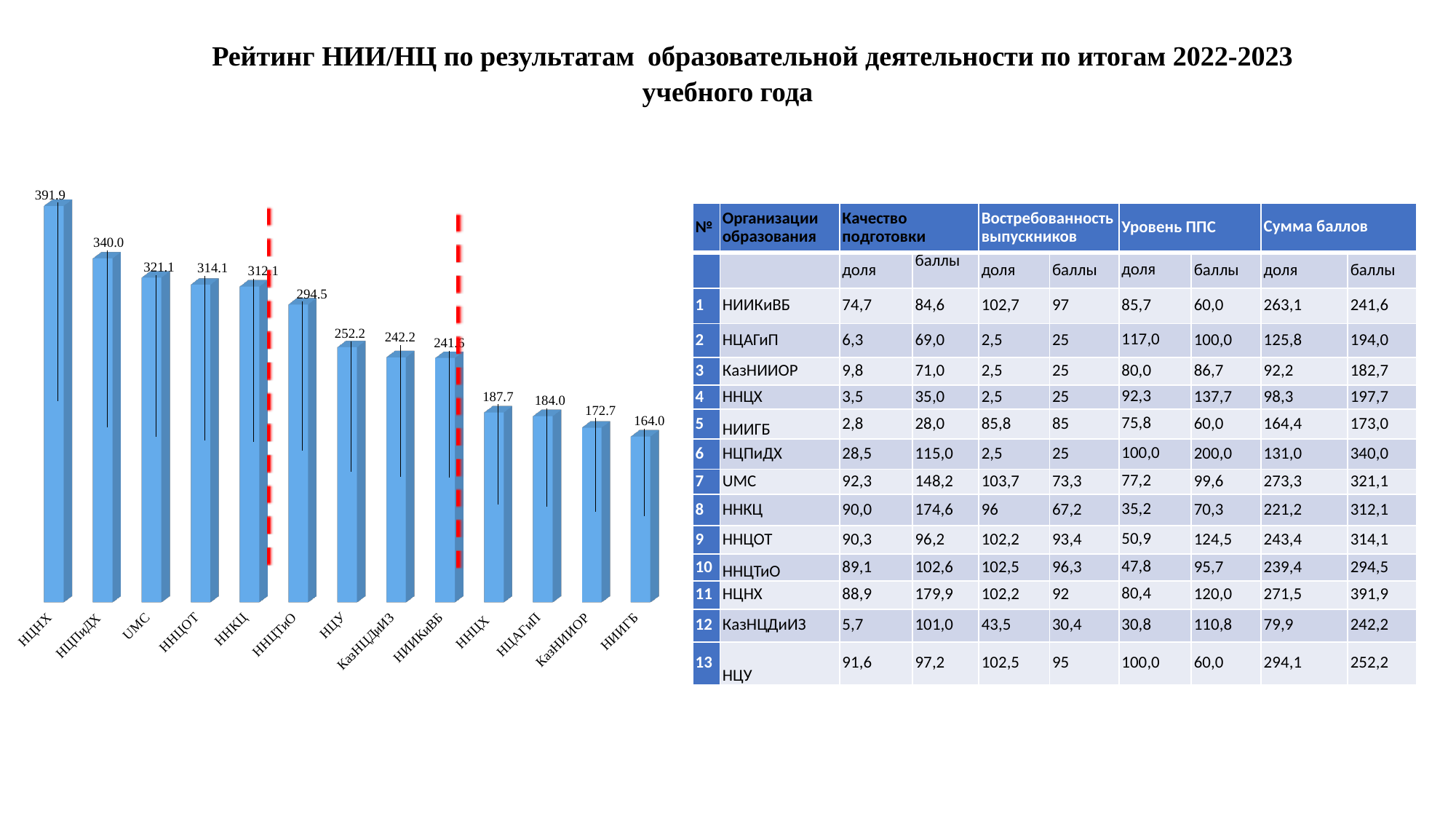
What is the value for НЦНХ in the bar chart? 391.9 What is the value for НИИГБ in the bar chart? 164.0 In the bar chart, which is larger: the value for UMC or the value for ННЦОТ? UMC What kind of chart is shown on the left of the slide? bar chart Which organisation has the highest bar in the chart? НЦНХ What is the difference between the values for НЦНХ and НЦПиДХ in the bar chart? 51.9 What is the value for ННЦТиО in the bar chart? 294.5 Do the values in the bar chart rise or fall from left to right? fall How many organisations (bars) are shown in the bar chart? 13 What is the value for НЦУ in the bar chart? 252.2 Which organisation has the lowest bar in the chart? НИИГБ What is the difference between the values for ННЦХ and НЦАГиП in the bar chart? 3.7